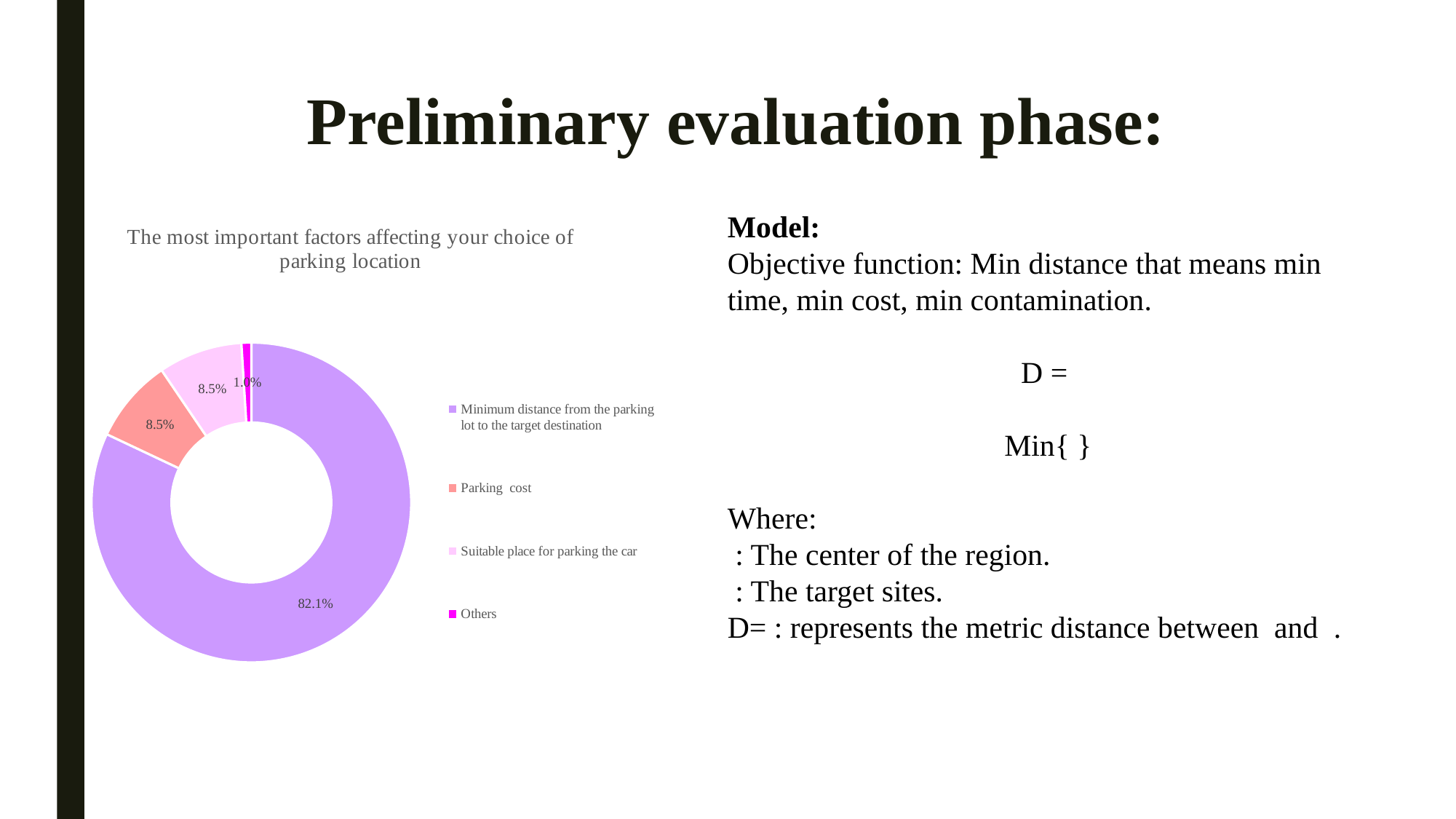
What is the value shown for "Suitable place for parking the car"? 8.5% Which category has the largest share of the chart? Minimum distance from the parking lot to the target destination What is the value shown for "Others"? 1.0% Which is larger, the share for "Parking cost" or the share for "Others"? Parking cost Which category has the smallest share of the chart? Others What share of the chart does "Minimum distance from the parking lot to the target destination" account for? 82.1% How many categories are shown in the chart? 4 What kind of chart is shown on the slide? doughnut chart How many entries does the chart's legend list? 4 What is the value shown for "Parking cost"? 8.5% What is the title of the chart on the slide? The most important factors affecting your choice of parking location What is the difference between the share for "Minimum distance from the parking lot to the target destination" and the share for "Parking cost"? 73.6%